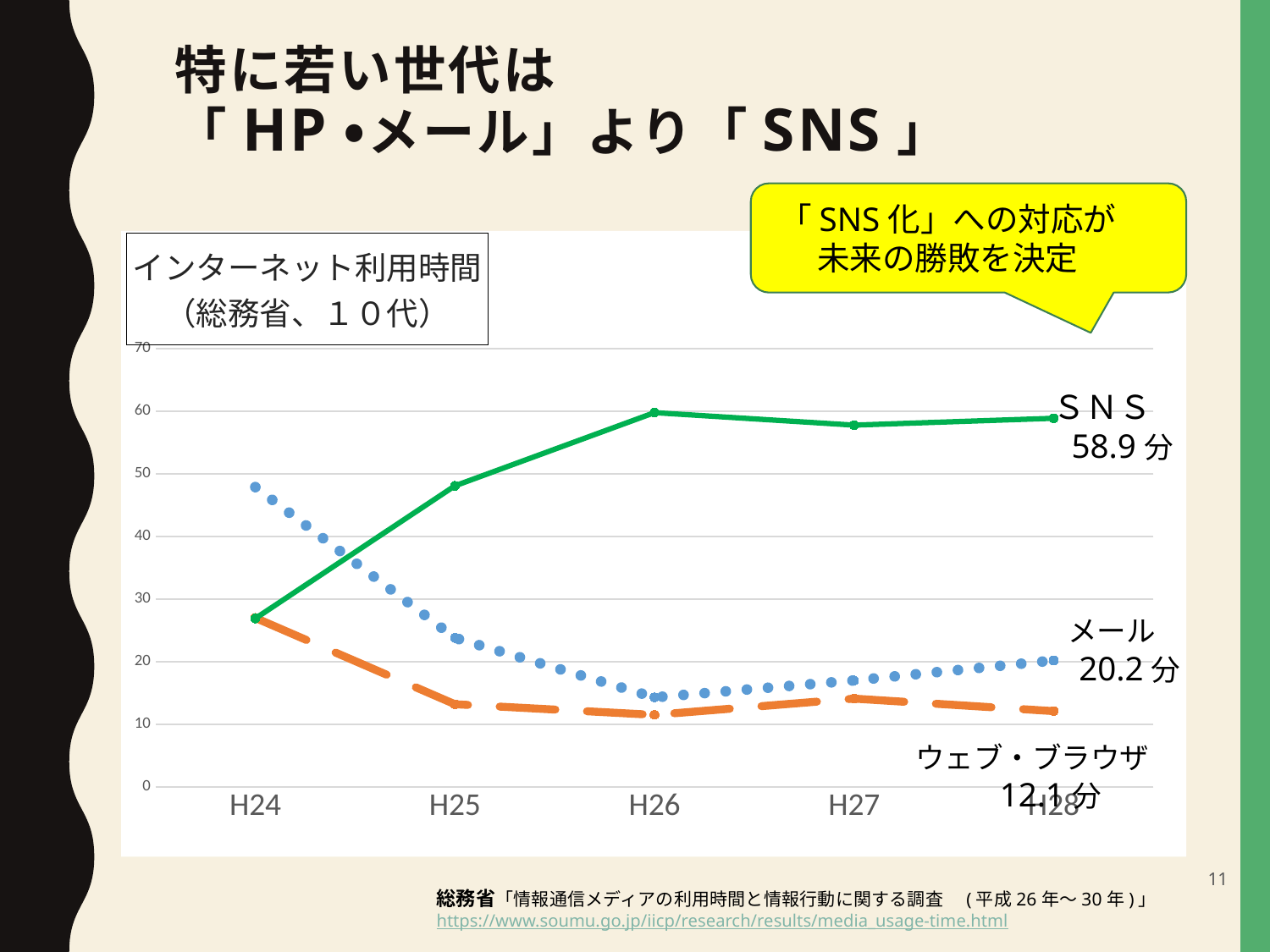
What kind of chart is shown on the slide? Line chart Is the value for メール at H24 greater or less than 40? greater What is the value for ウェブ・ブラウザ at H28? 12.1分 What is the difference between the SNS value and the メール value at H28? 38.7分 Is the value for SNS at H26 greater or less than 50? greater What is the value for メール at H28? 20.2分 At H25, which is larger: the SNS value or the メール value? SNS Which series has the highest value at H28? SNS Which series has the lowest value at H28? ウェブ・ブラウザ How many series are plotted on the chart? 3 How many years are shown on the x axis? 5 What is the value for SNS at H28? 58.9分